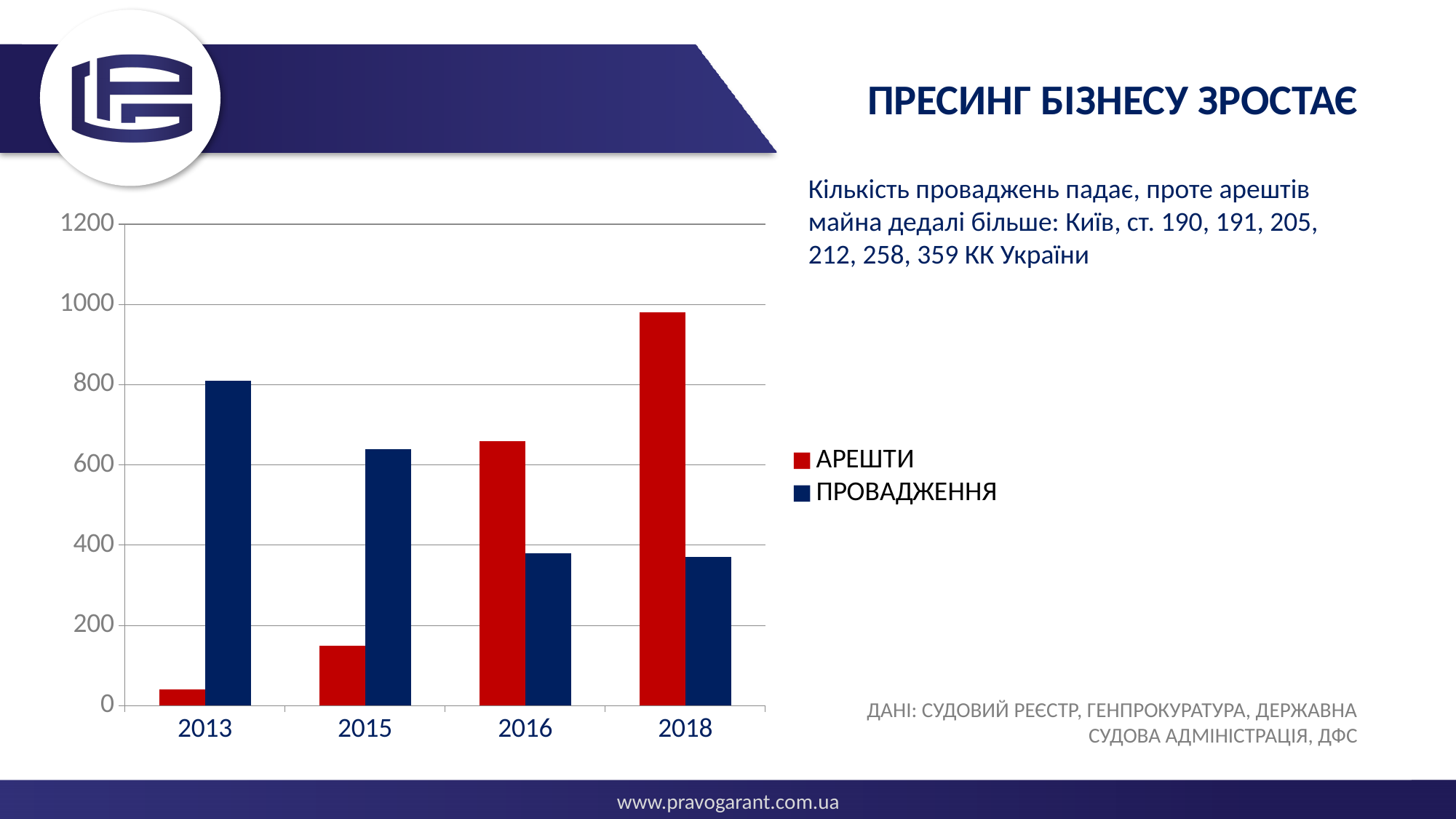
What kind of chart is shown on the slide? bar chart How many years are shown on the x axis of the chart? 4 Which year has the highest value for ПРОВАДЖЕННЯ? 2013 Is the value for АРЕШТИ in 2018 greater or less than 1000? less Do the values for ПРОВАДЖЕННЯ rise or fall from 2013 to 2018? fall Which year has the highest value for АРЕШТИ? 2018 How many series does the legend list? 2 Is the value for АРЕШТИ in 2015 greater or less than 200? less In 2016, which is larger: АРЕШТИ or ПРОВАДЖЕННЯ? АРЕШТИ Which year has the lowest value for АРЕШТИ? 2013 Which colour represents АРЕШТИ in the chart? red